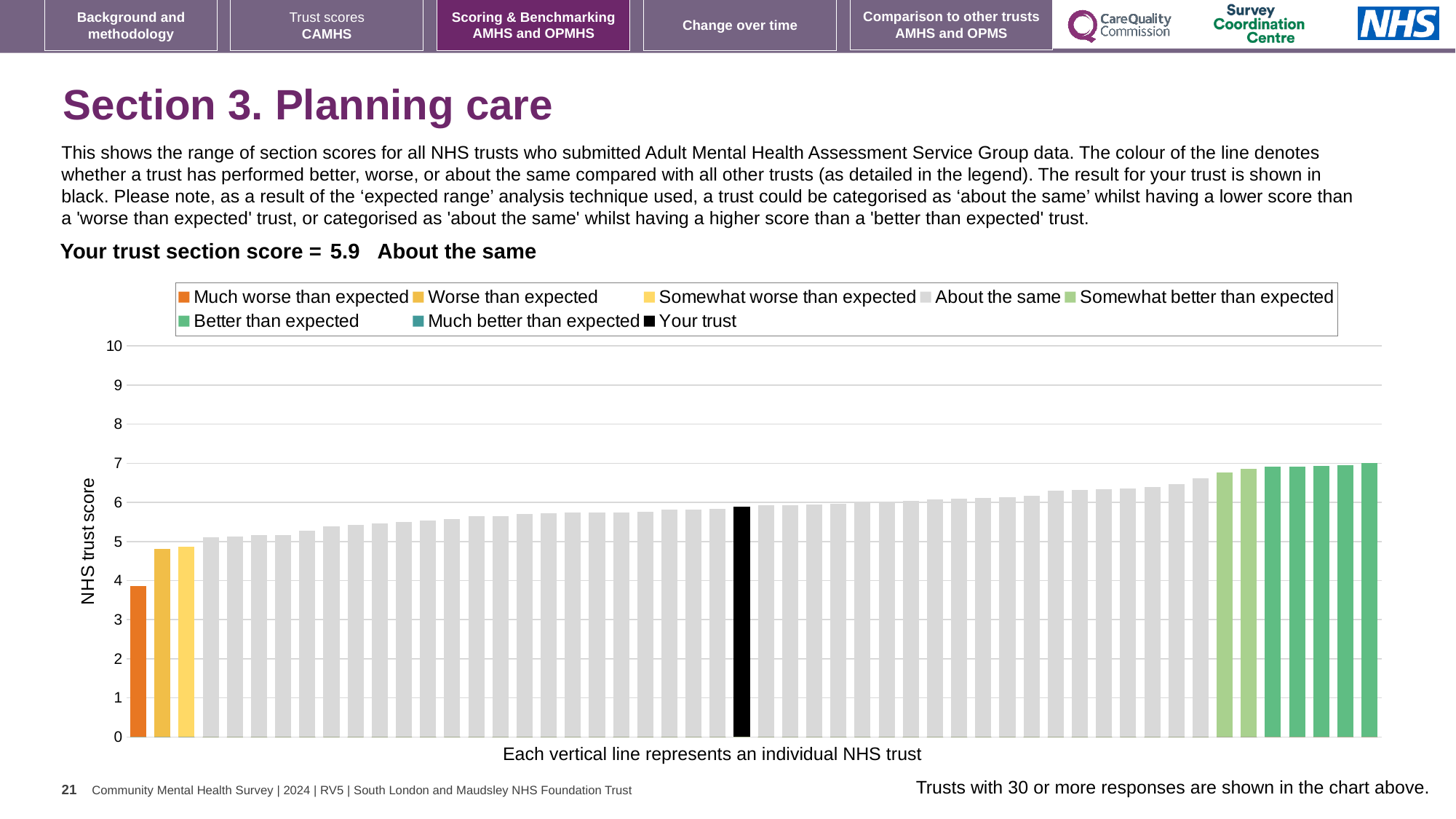
Is the value for the lowest bar (Much worse than expected) greater or less than 5? less Do the bar values rise or fall from left to right along the x axis? rise Which legend category does the lowest bar belong to? Much worse than expected How many entries does the chart legend list? 8 What kind of chart is shown on the slide? bar chart What is the label on the y axis of the chart? NHS trust score What is your trust's section score shown on the slide? 5.9 What colour is used for 'Your trust' in the chart? black Is the value for the highest bar greater or less than 6? greater Which legend category does the highest bar belong to? Better than expected How many bars are coloured as 'Worse than expected'? 1 Is the value for your trust (black bar) greater or less than 5? greater